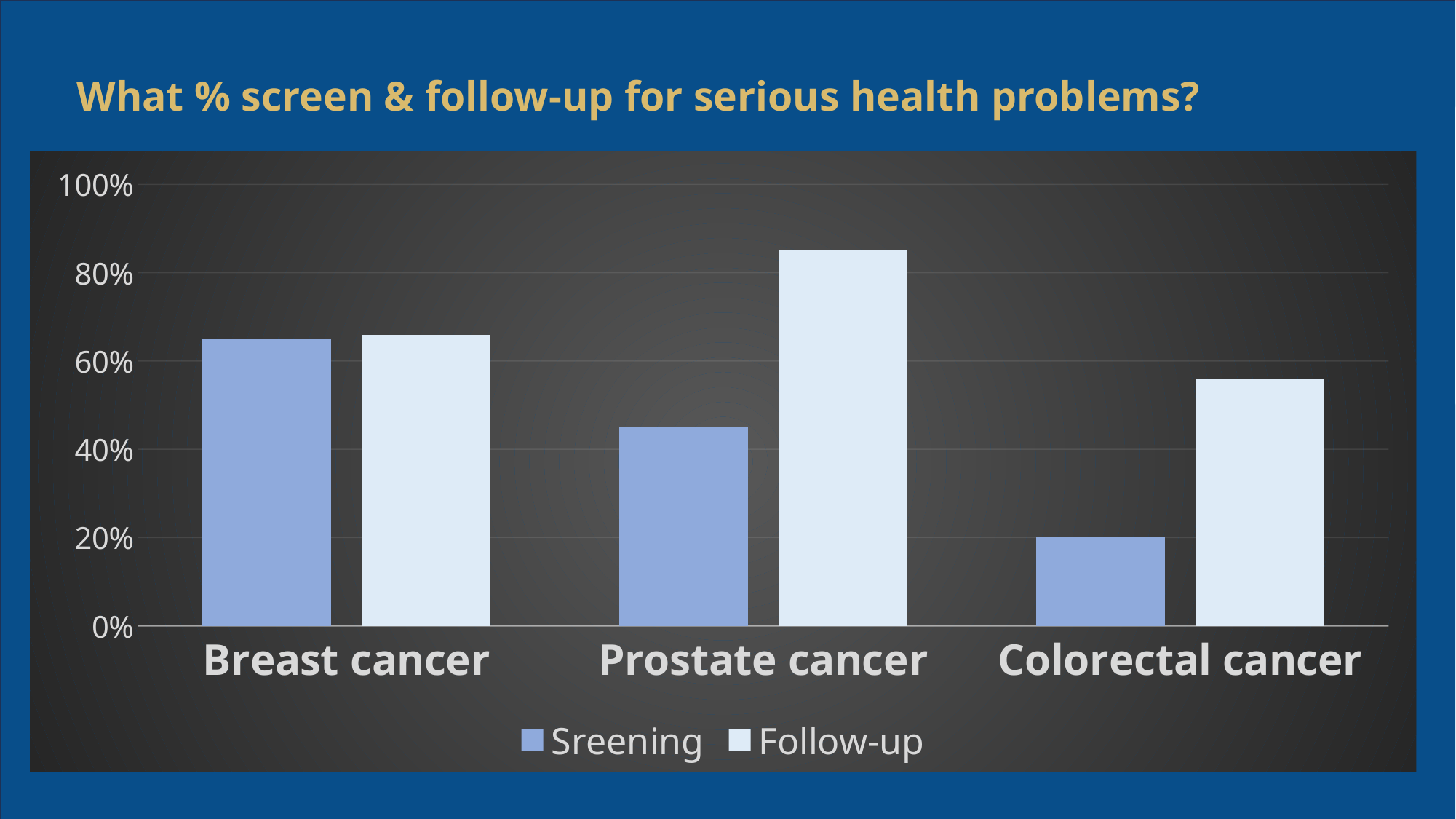
Is the Sreening value for Breast cancer greater or less than 60%? greater Do the Sreening values rise or fall moving from Breast cancer to Colorectal cancer along the x axis? fall Is the Follow-up value for Colorectal cancer greater or less than 40%? greater For Prostate cancer, which is larger: the Sreening value or the Follow-up value? Follow-up Which category has the highest Follow-up value? Prostate cancer How many cancer categories are shown on the x axis? 3 Which category has the lowest Sreening value? Colorectal cancer What kind of chart is shown on the slide? bar chart Is the Sreening value for Prostate cancer greater or less than 60%? less How many series does the legend list? 2 What is the title of the chart? What % screen & follow-up for serious health problems?